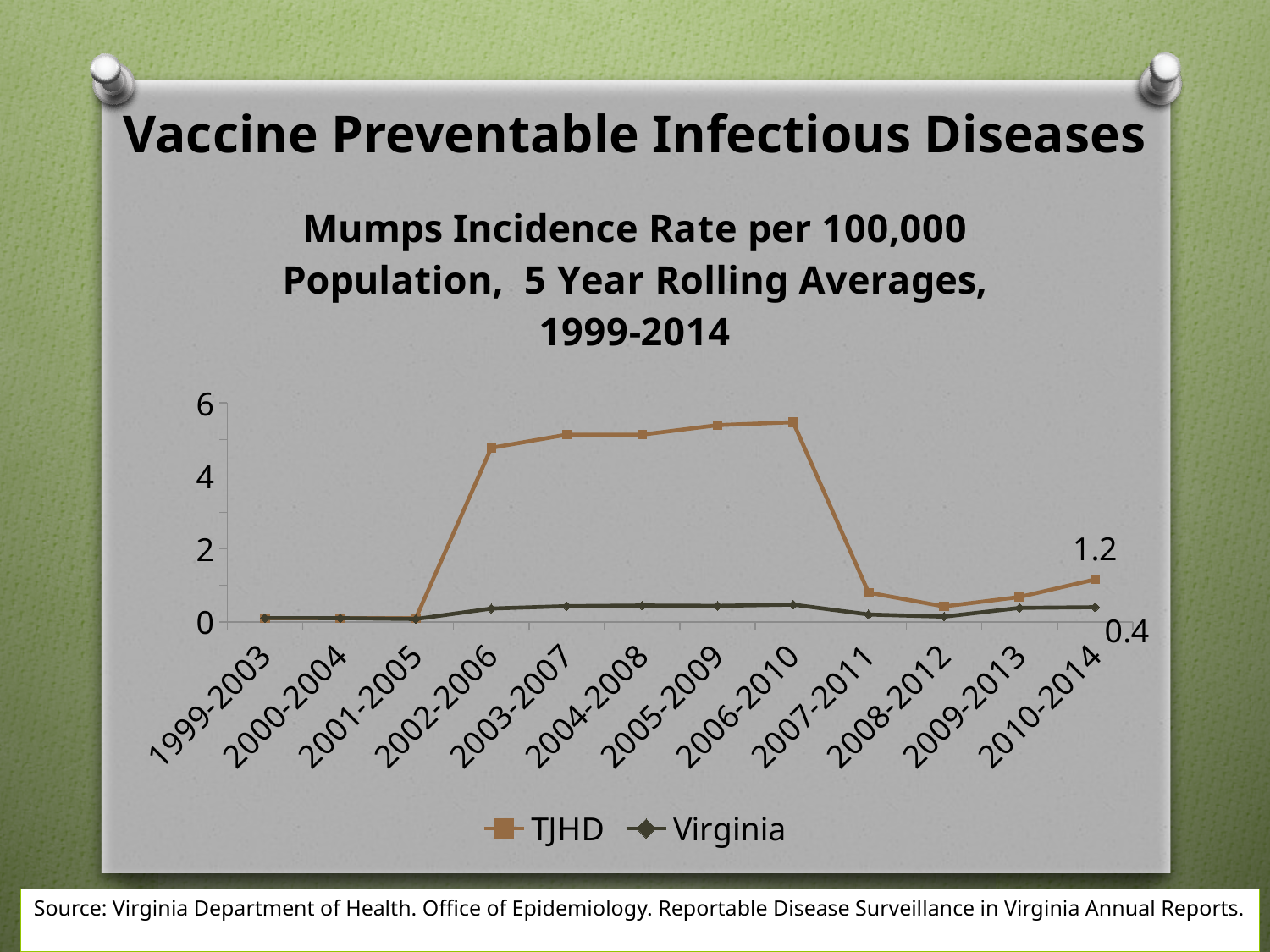
What are the two entries in the chart's legend? TJHD and Virginia What is the Virginia mumps incidence rate for 2010-2014? 0.4 How many periods are shown on the x axis? 12 Is the TJHD value for 2006-2010 greater or less than 4? greater How many series does the legend list? 2 What kind of chart is shown on the slide? line chart What is the difference between the TJHD and Virginia rates for 2010-2014? 0.8 Which series has the higher value for 2010-2014, TJHD or Virginia? TJHD Does the TJHD line rise or fall from 2006-2010 to 2007-2011? fall Is the TJHD value for 2008-2012 greater or less than 2? less Is the Virginia value for 2005-2009 greater or less than 2? less What is the TJHD mumps incidence rate for 2010-2014? 1.2